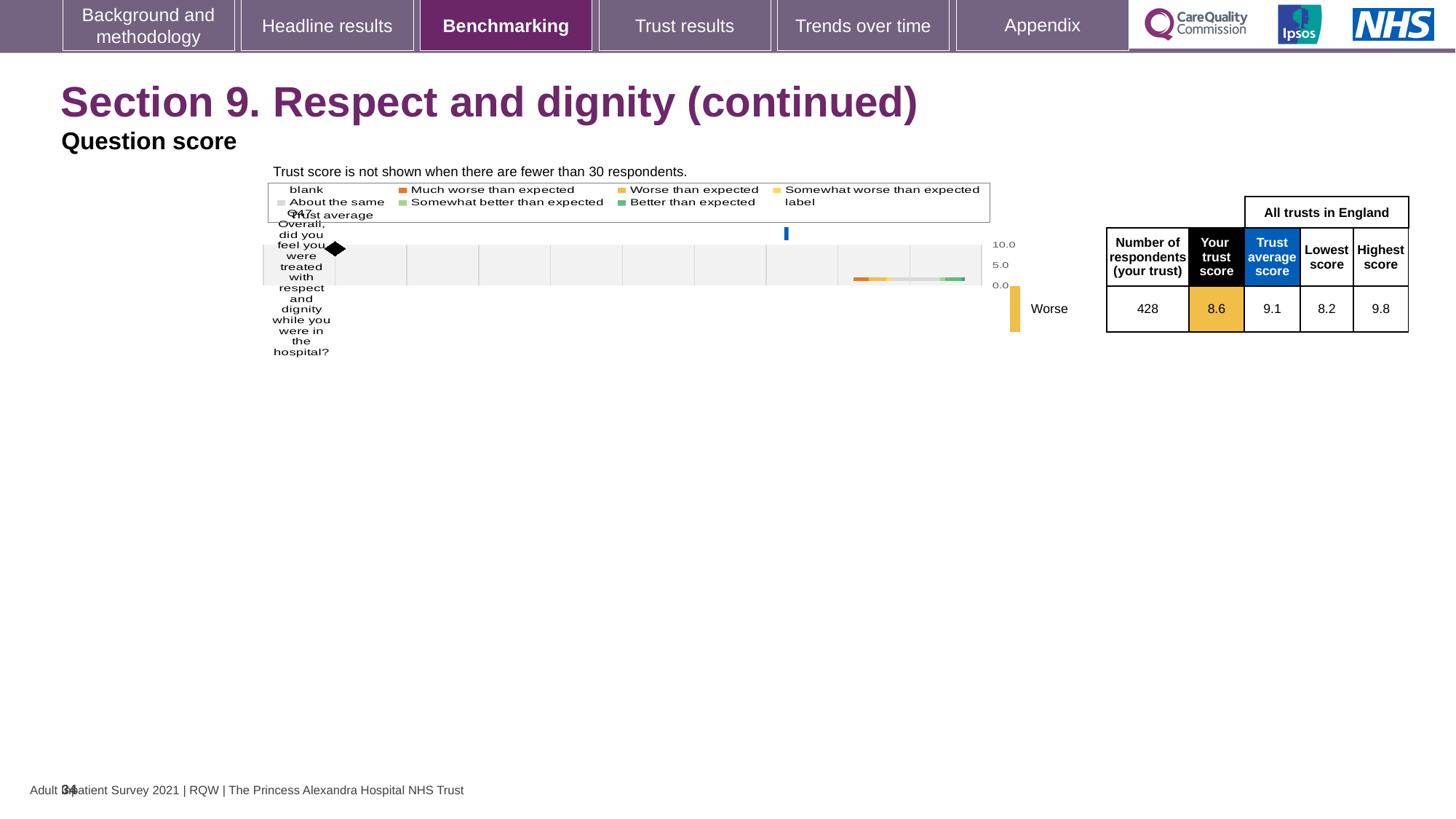
Which question number is plotted on the chart? Q47 What is the difference between the trust average score and your trust score for Q47? 0.5 What is the difference between the highest score and the lowest score for Q47? 1.6 What is the trust average score for Q47? 9.1 What kind of chart is shown on the slide? bar chart What is the highest score among all trusts in England for Q47? 9.8 What is the number of respondents for your trust shown in the table next to the chart? 428 What is the lowest score among all trusts in England for Q47? 8.2 Which is larger for Q47, your trust score or the trust average score? Trust average score According to the note above the chart, below how many respondents is the trust score not shown? 30 What is your trust score for Q47? 8.6 What benchmark rating label is shown beside the chart for Q47? Worse